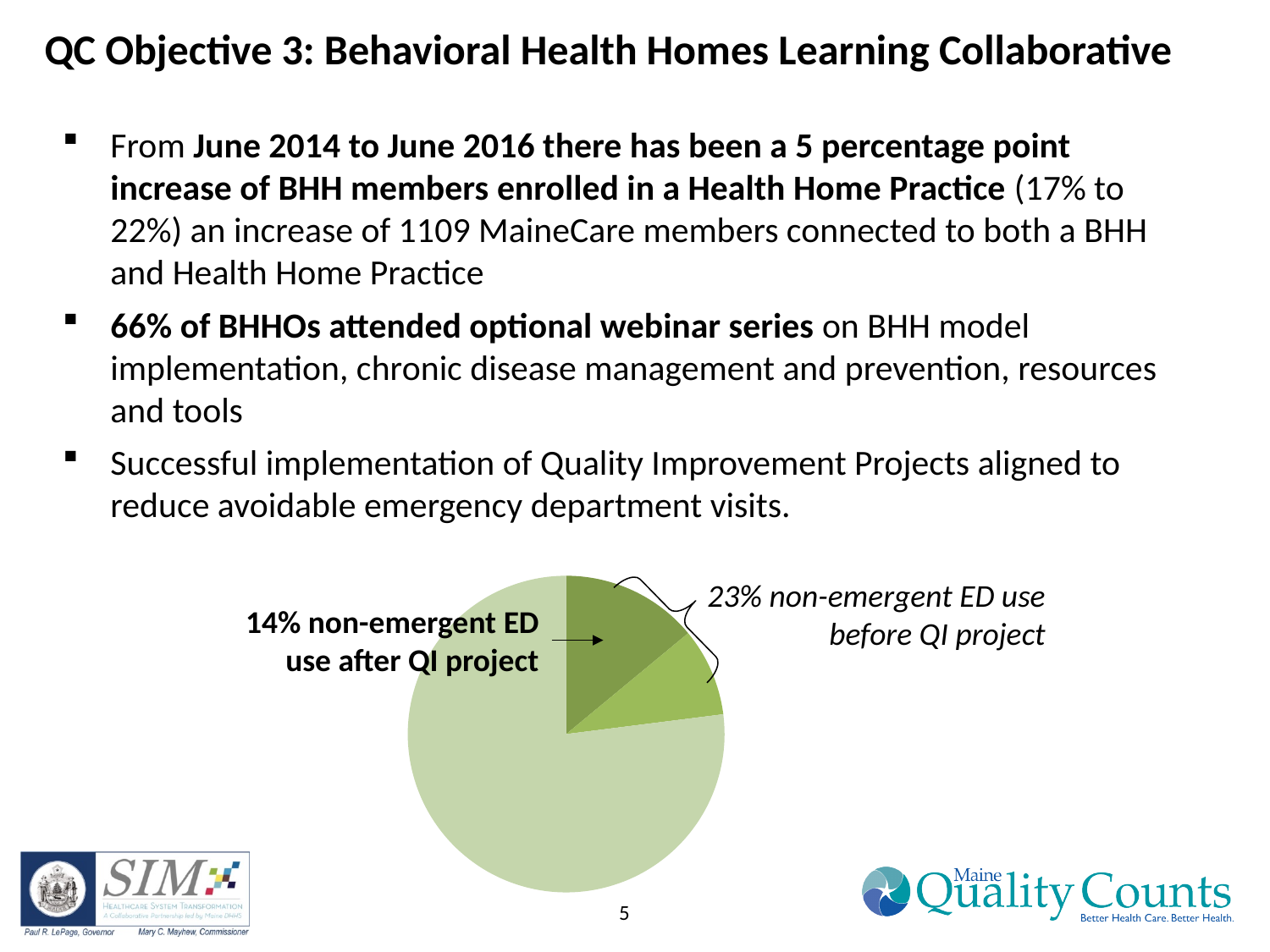
How many slices does the pie chart have? 3 By how many percentage points did non-emergent ED use fall from before to after the QI project? 9 percentage points What share of the pie does the slice labeled 'non-emergent ED use after QI project' represent? 14% What kind of chart is shown at the bottom of the slide? pie chart Which is larger, non-emergent ED use before the QI project or after the QI project? before QI project Which labeled value in the pie chart is the smallest? 14% non-emergent ED use after QI project What colour is the slice labeled '14% non-emergent ED use after QI project'? dark green What percentage of non-emergent ED use is shown after the QI project? 14% Does the pie chart have a legend? No Which slice of the pie chart is the largest? the unlabeled light green slice What percentage of non-emergent ED use is shown before the QI project? 23%